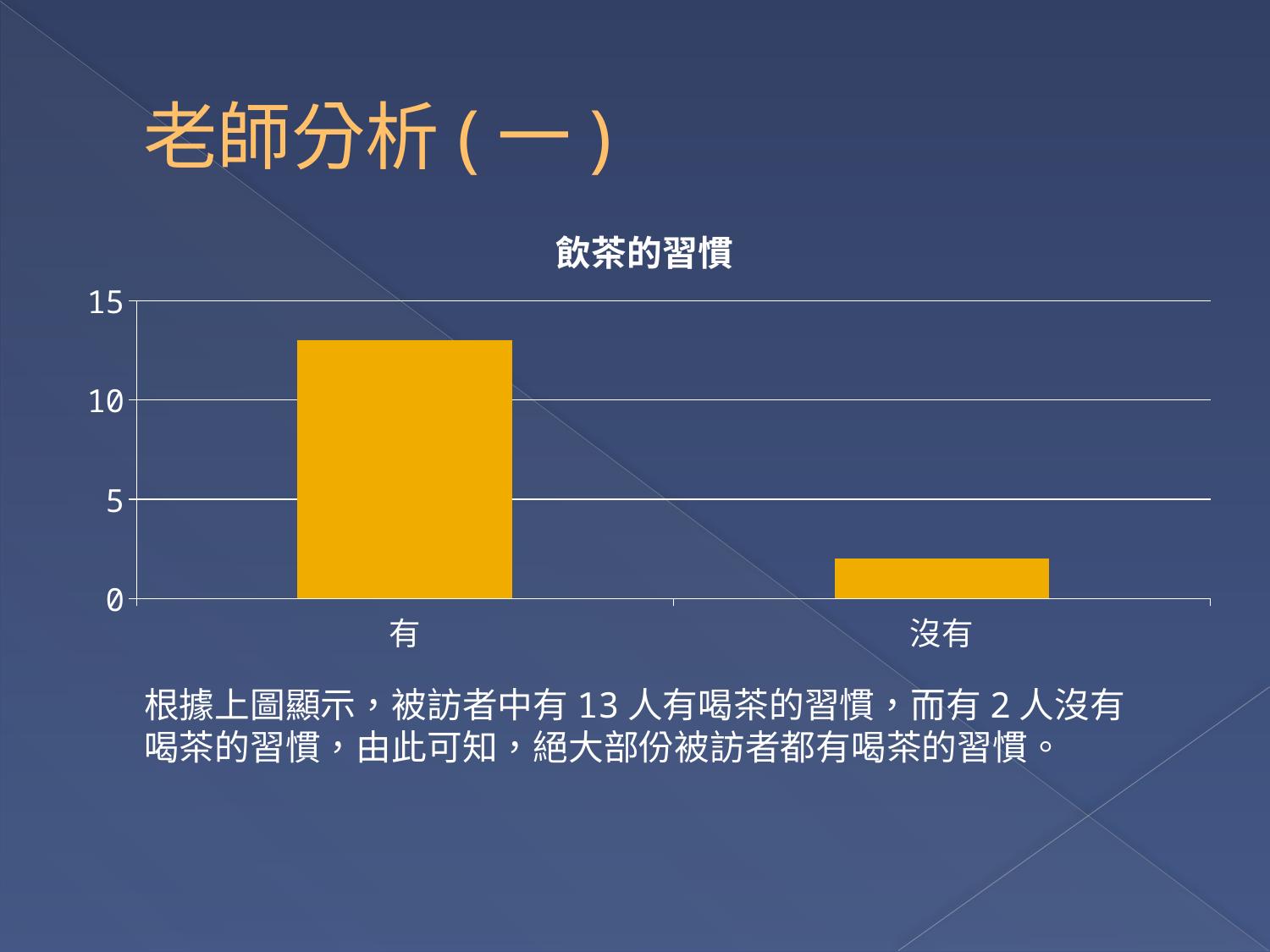
What is the highest value shown on the y axis of the chart? 15 What is the difference between the number of respondents for 有 and 沒有, as stated on the slide? 11 Which is larger, the value for 有 or the value for 沒有? 有 How many categories are shown on the x axis of the chart? 2 What type of chart is shown on the slide? bar chart Is the value for 有 greater or less than 10? greater What is the title of the chart? 飲茶的習慣 According to the slide, how many respondents do not have the habit of drinking tea (沒有)? 2 Which category has the lowest value in the chart? 沒有 Is the value for 沒有 greater or less than 5? less According to the slide, how many respondents have the habit of drinking tea (有)? 13 Which category has the highest value in the chart? 有